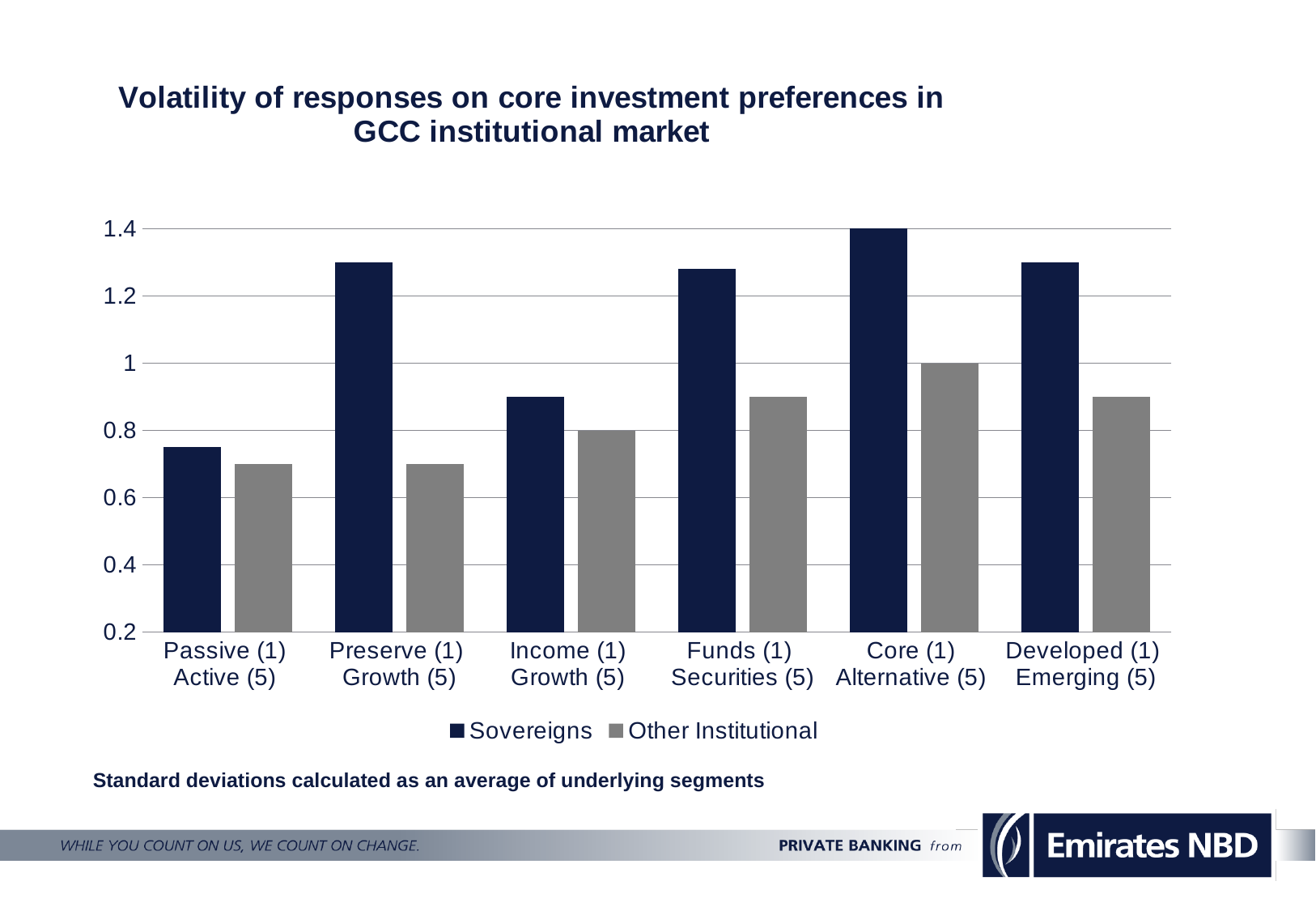
How many series does the legend list? 2 What is the Sovereigns value for Core (1) Alternative (5)? 1.4 Which category has the highest Other Institutional value? Core (1) Alternative (5) Is the Other Institutional value for Passive (1) Active (5) greater or less than 0.8? less Is the Sovereigns value for Preserve (1) Growth (5) greater or less than 1.2? greater What is the Other Institutional value for Core (1) Alternative (5)? 1 What is the Other Institutional value for Income (1) Growth (5)? 0.8 What kind of chart is shown on the slide? bar chart Which category has the highest Sovereigns value? Core (1) Alternative (5) For Funds (1) Securities (5), which series has the larger value, Sovereigns or Other Institutional? Sovereigns How many categories are shown on the x axis? 6 Which category has the lowest Sovereigns value? Passive (1) Active (5)